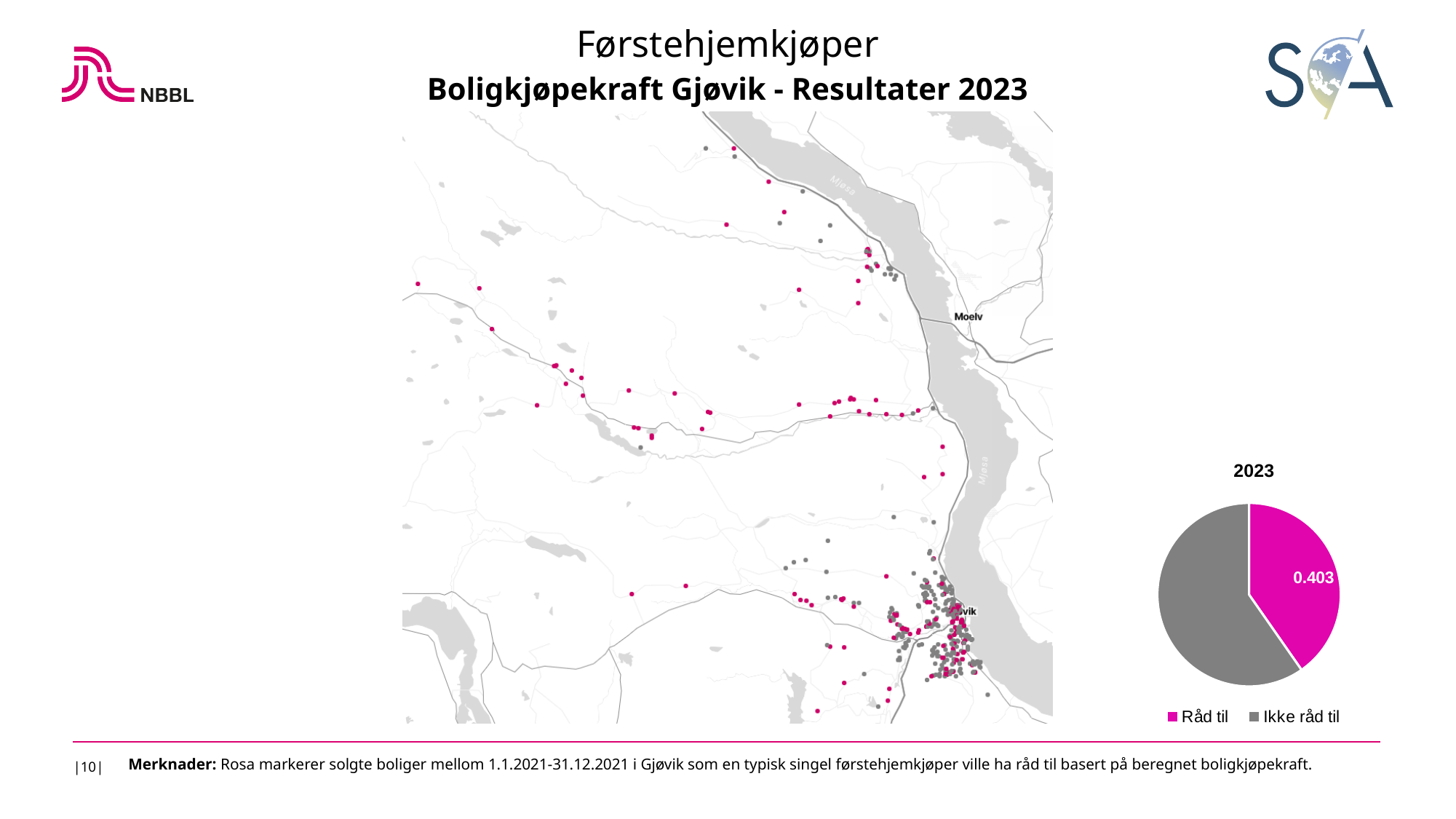
In the pie chart titled 2023, which slice is the largest? Ikke råd til How many slices does the pie chart titled 2023 have? 2 In the pie chart titled 2023, which is larger: Råd til or Ikke råd til? Ikke råd til How many entries does the legend of the pie chart list? 2 What share of the pie chart titled 2023 does the Råd til slice represent? 0.403 What kind of chart is shown on the right side of the slide? pie chart In the pie chart titled 2023, which slice is the smallest? Råd til In the pie chart titled 2023, what value is shown for Råd til? 0.403 What is the title shown above the pie chart? 2023 What colour is the Råd til slice in the pie chart? pink